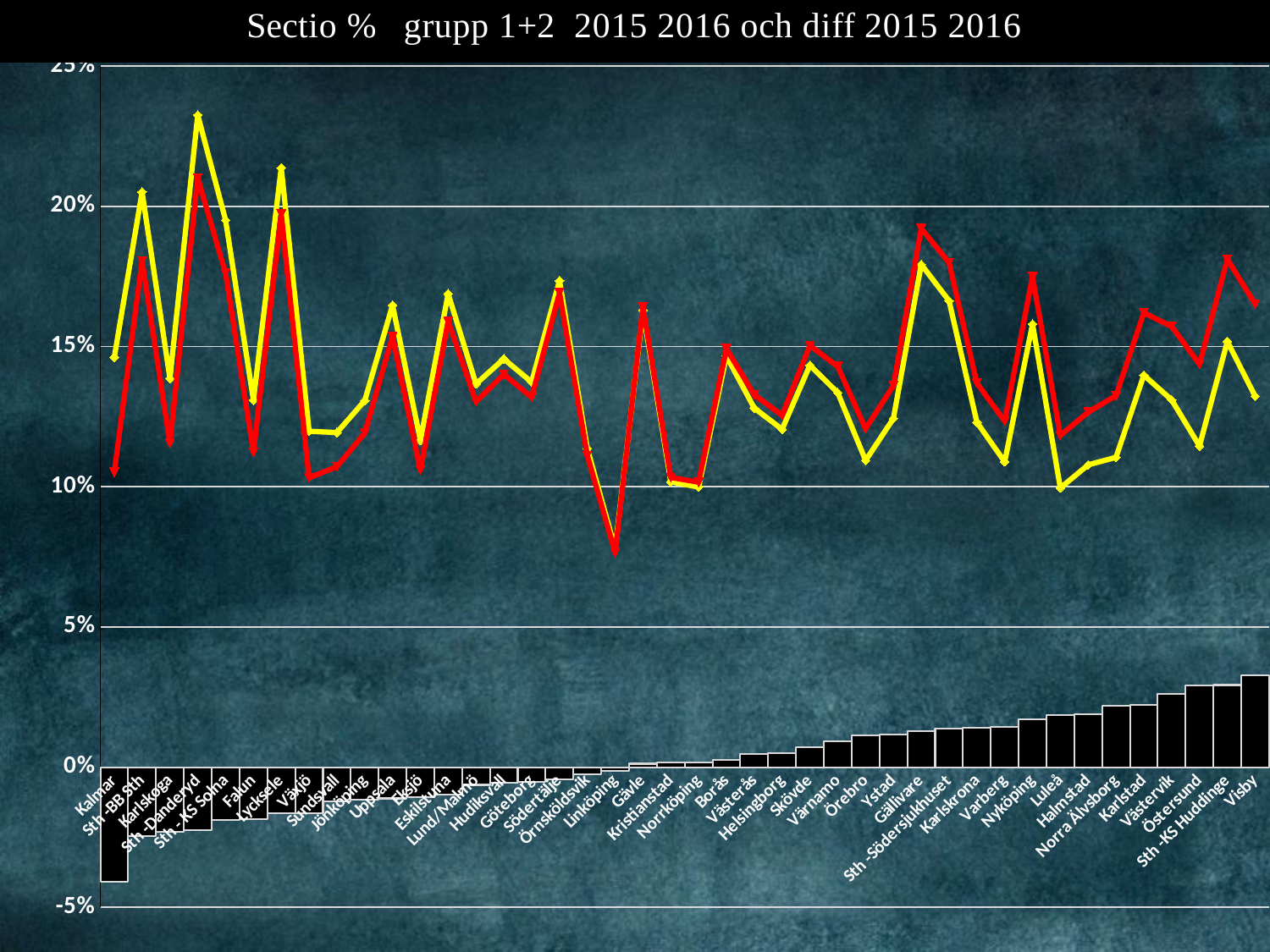
Do the black bars rise or fall from left to right along the x axis? rise Which category has the highest black bar? Visby What is the title of the chart? Sectio % grupp 1+2 2015 2016 och diff 2015 2016 Which category has the highest value on the yellow line? Sth-Danderyd What kind of chart is shown on the slide? A combined line and bar chart Is the red line value for Gällivare greater or less than 15%? greater Is the red line value for Linköping greater or less than 10%? less Which category has the lowest (most negative) black bar? Kalmar Is the yellow line value for Sth-Danderyd greater or less than 20%? greater Which category has the lowest value on the red line? Linköping On the yellow line, which is higher: Sth-Danderyd or Lycksele? Sth-Danderyd